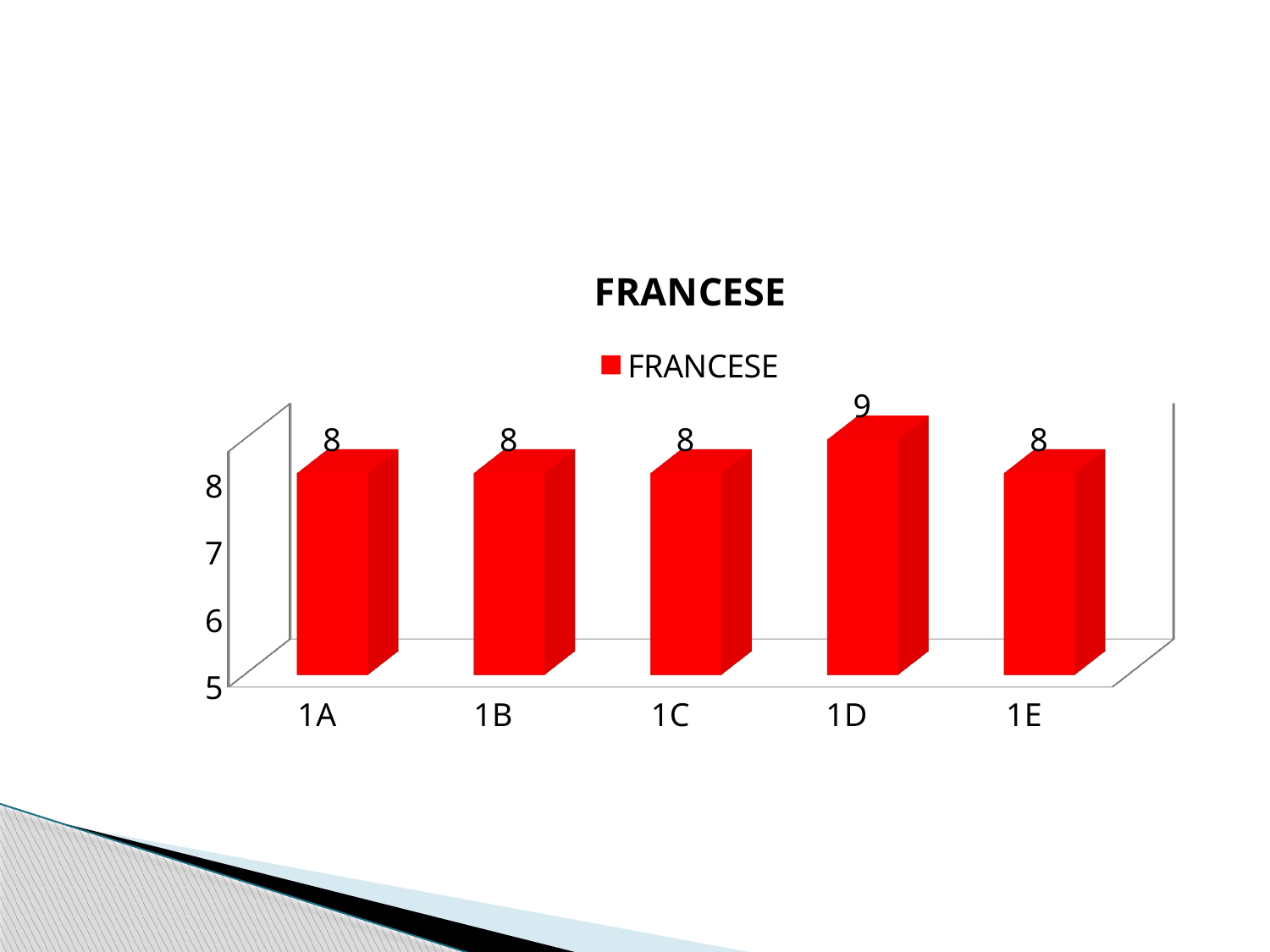
How many series does the legend list? 1 What colour are the bars? red What kind of chart is shown? bar chart What is the value for 1A? 8 What is the difference between the values for 1D and 1C? 1 Which category has the highest value? 1D Is the value for 1D greater or less than 8? greater What is the title of the chart? FRANCESE What is the value for 1D? 9 Which is larger, the value for 1D or the value for 1B? 1D How many categories are shown on the x axis? 5 What is the value for 1E? 8